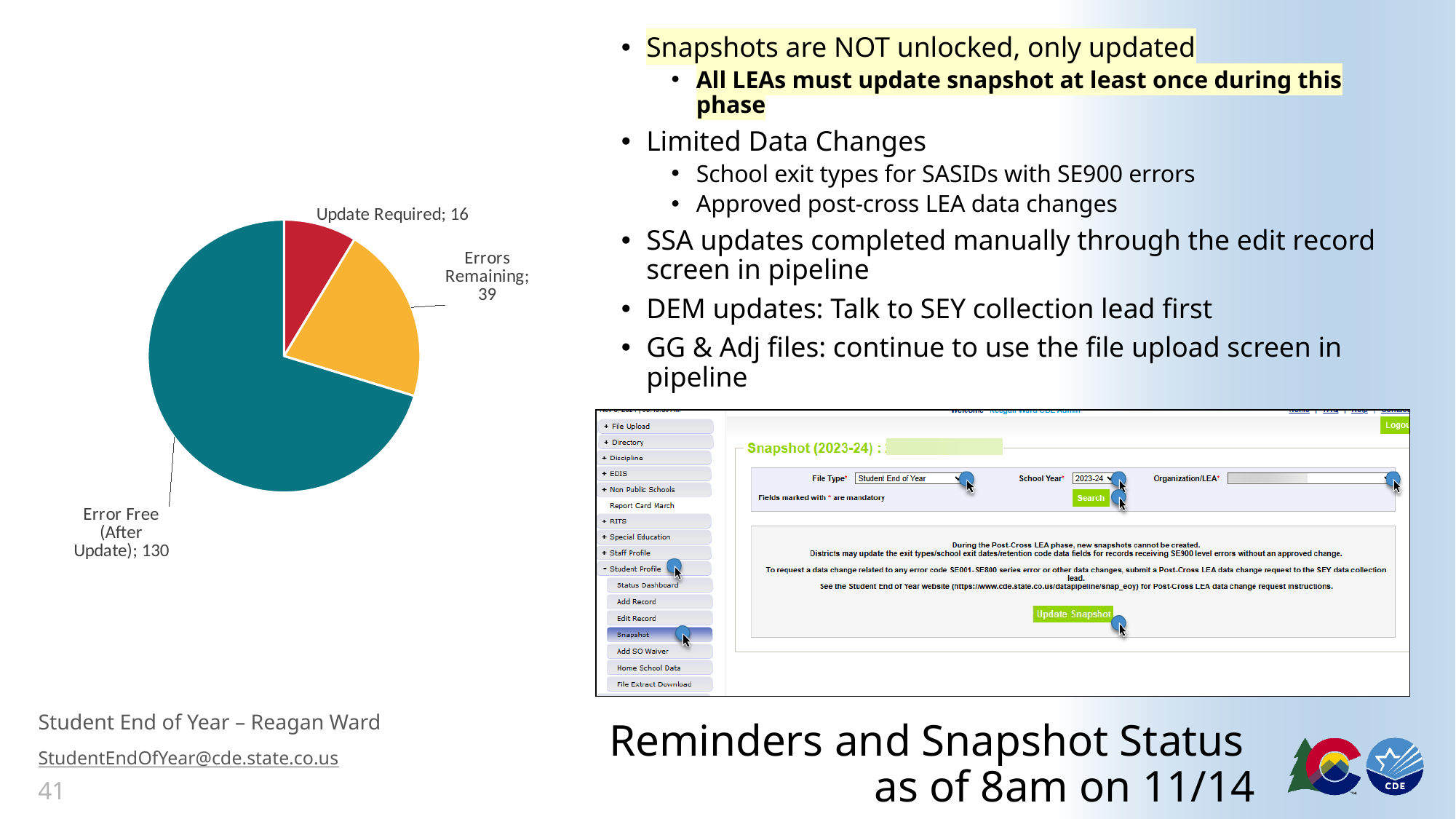
What is the total of all slices in the pie chart? 185 What is the value for the Update Required slice in the pie chart? 16 Which category has the largest slice in the pie chart? Error Free (After Update) What is the difference between the Error Free (After Update) value and the Errors Remaining value in the pie chart? 91 How many slices does the pie chart have? 3 What colour is the Error Free (After Update) slice in the pie chart? Teal What is the difference between the Errors Remaining value and the Update Required value in the pie chart? 23 What is the value for the Error Free (After Update) slice in the pie chart? 130 Which category has the smallest slice in the pie chart? Update Required What kind of chart is shown on the left of the slide? Pie chart What is the value for the Errors Remaining slice in the pie chart? 39 Which is larger in the pie chart, Errors Remaining or Update Required? Errors Remaining